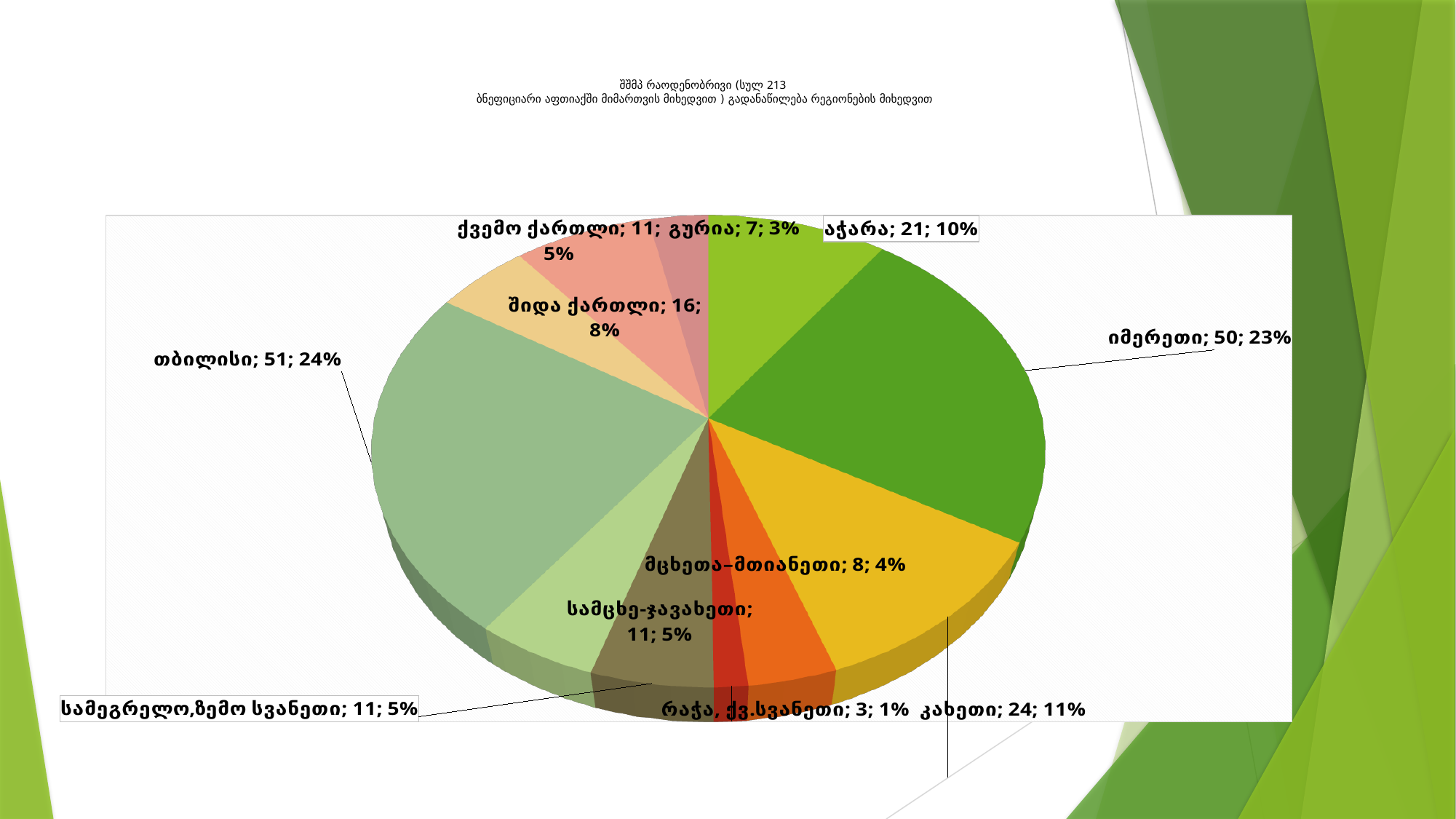
Which region has the smallest slice in the pie chart? რაჭა, ქვ.სვანეთი What percentage share does იმერეთი have in the pie chart? 23% What is the value shown for თბილისი? 51 What type of chart is shown on the slide? pie chart What total number of beneficiaries is stated in the chart title? 213 What is the difference between the values for კახეთი and მცხეთა-მთიანეთი? 16 What percentage share does გურია have in the pie chart? 3% What is the difference between the values for თბილისი and იმერეთი? 1 How many slices does the pie chart have? 11 Which region has the largest slice in the pie chart? თბილისი What is the value shown for კახეთი? 24 Which is larger, the value for აჭარა or the value for შიდა ქართლი? აჭარა